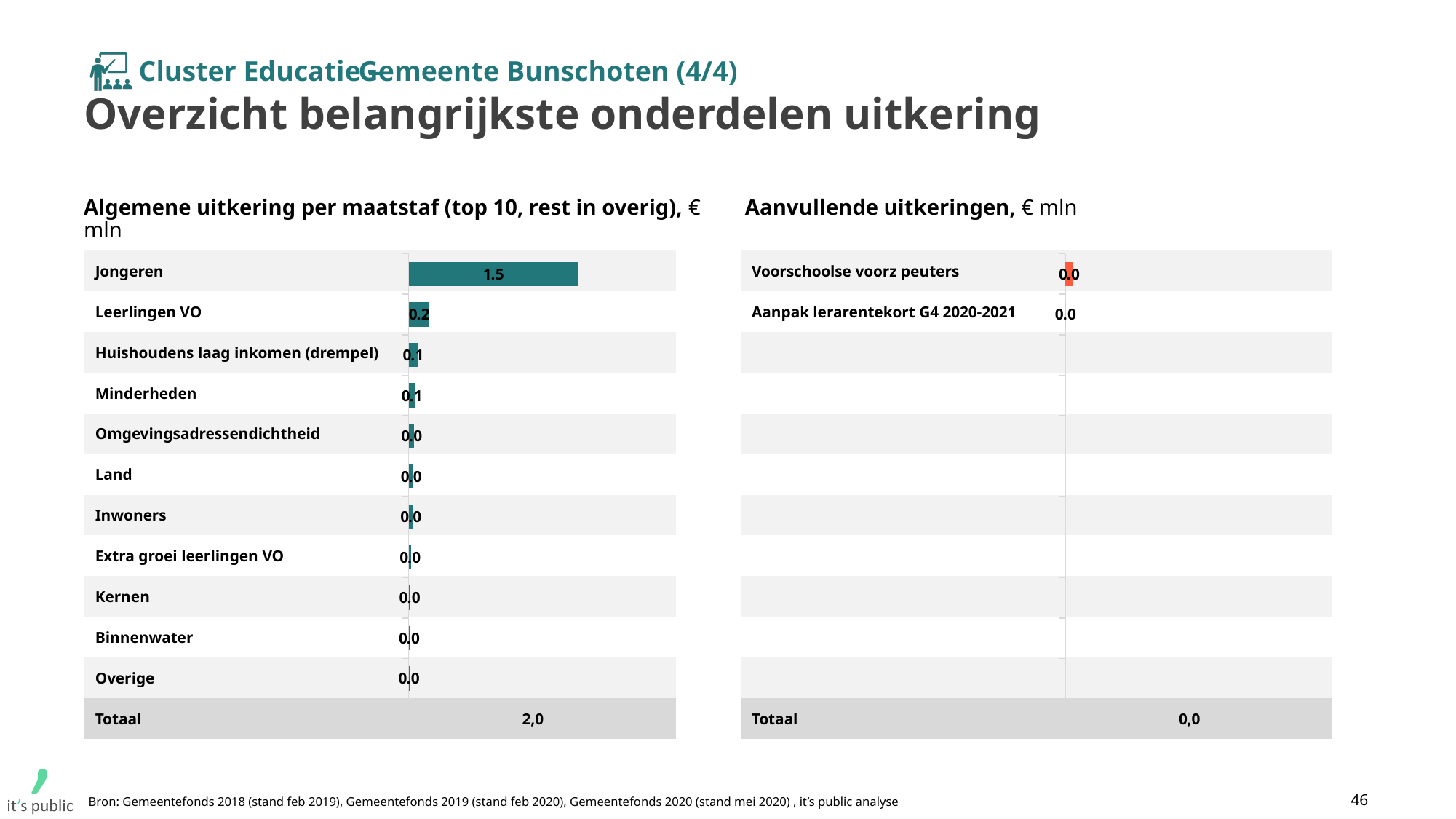
In the chart 'Algemene uitkering per maatstaf', which is larger: the value for Jongeren or the value for Huishoudens laag inkomen (drempel)? Jongeren In the chart 'Algemene uitkering per maatstaf', which category has the highest value? Jongeren In the chart 'Aanvullende uitkeringen', what is the value for Aanpak lerarentekort G4 2020-2021? 0.0 What is the Totaal shown for the chart 'Algemene uitkering per maatstaf'? 2,0 How many categories are shown in the chart 'Algemene uitkering per maatstaf' (excluding the Totaal row)? 11 In the chart 'Algemene uitkering per maatstaf', what is the value for Jongeren? 1.5 What kind of chart is the 'Algemene uitkering per maatstaf' chart? Bar chart In the chart 'Algemene uitkering per maatstaf', what is the value for Leerlingen VO? 0.2 What unit is stated in the title of the chart 'Aanvullende uitkeringen'? € mln In the chart 'Algemene uitkering per maatstaf', what is the value for Minderheden? 0.1 In the chart 'Algemene uitkering per maatstaf', what is the difference between the values for Jongeren and Leerlingen VO? 1.3 How many categories are shown in the chart 'Aanvullende uitkeringen' (excluding the Totaal row)? 2